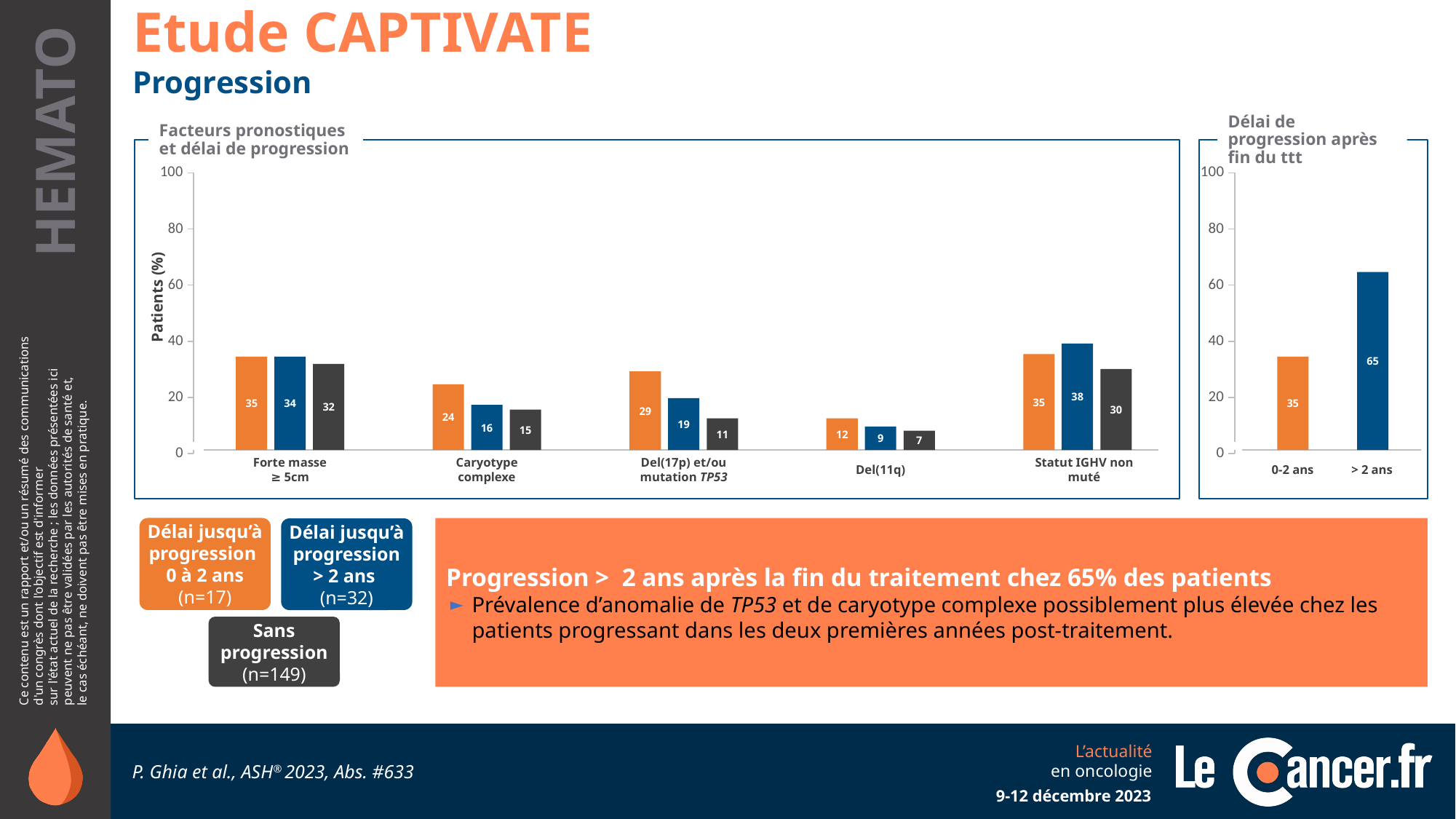
In the 'Délai de progression après fin du ttt' chart, what is the value for '> 2 ans'? 65 In the 'Facteurs pronostiques et délai de progression' chart, what is the value for 'Statut IGHV non muté' in the 'Délai jusqu'à progression > 2 ans' series? 38 What type of chart is the 'Délai de progression après fin du ttt' chart? Bar chart In the 'Facteurs pronostiques et délai de progression' chart, for 'Caryotype complexe', which is larger: the 'Délai jusqu'à progression 0 à 2 ans' value or the 'Sans progression' value? Délai jusqu'à progression 0 à 2 ans In the 'Facteurs pronostiques et délai de progression' chart, what is the value for 'Del(11q)' in the 'Sans progression' series? 7 How many series are shown in the 'Facteurs pronostiques et délai de progression' chart? 3 How many categories are shown on the x axis of the 'Facteurs pronostiques et délai de progression' chart? 5 In the 'Facteurs pronostiques et délai de progression' chart, which category has the highest value in the 'Délai jusqu'à progression > 2 ans' series? Statut IGHV non muté In the 'Délai de progression après fin du ttt' chart, what is the difference between the '> 2 ans' and '0-2 ans' values? 30 In the 'Facteurs pronostiques et délai de progression' chart, which category has the lowest value in the 'Délai jusqu'à progression 0 à 2 ans' series? Del(11q) In the 'Facteurs pronostiques et délai de progression' chart, what is the difference between the 'Délai jusqu'à progression 0 à 2 ans' and 'Sans progression' values for 'Del(17p) et/ou mutation TP53'? 18 In the 'Facteurs pronostiques et délai de progression' chart, what is the value for 'Forte masse ≥ 5cm' in the 'Délai jusqu'à progression 0 à 2 ans' series? 35